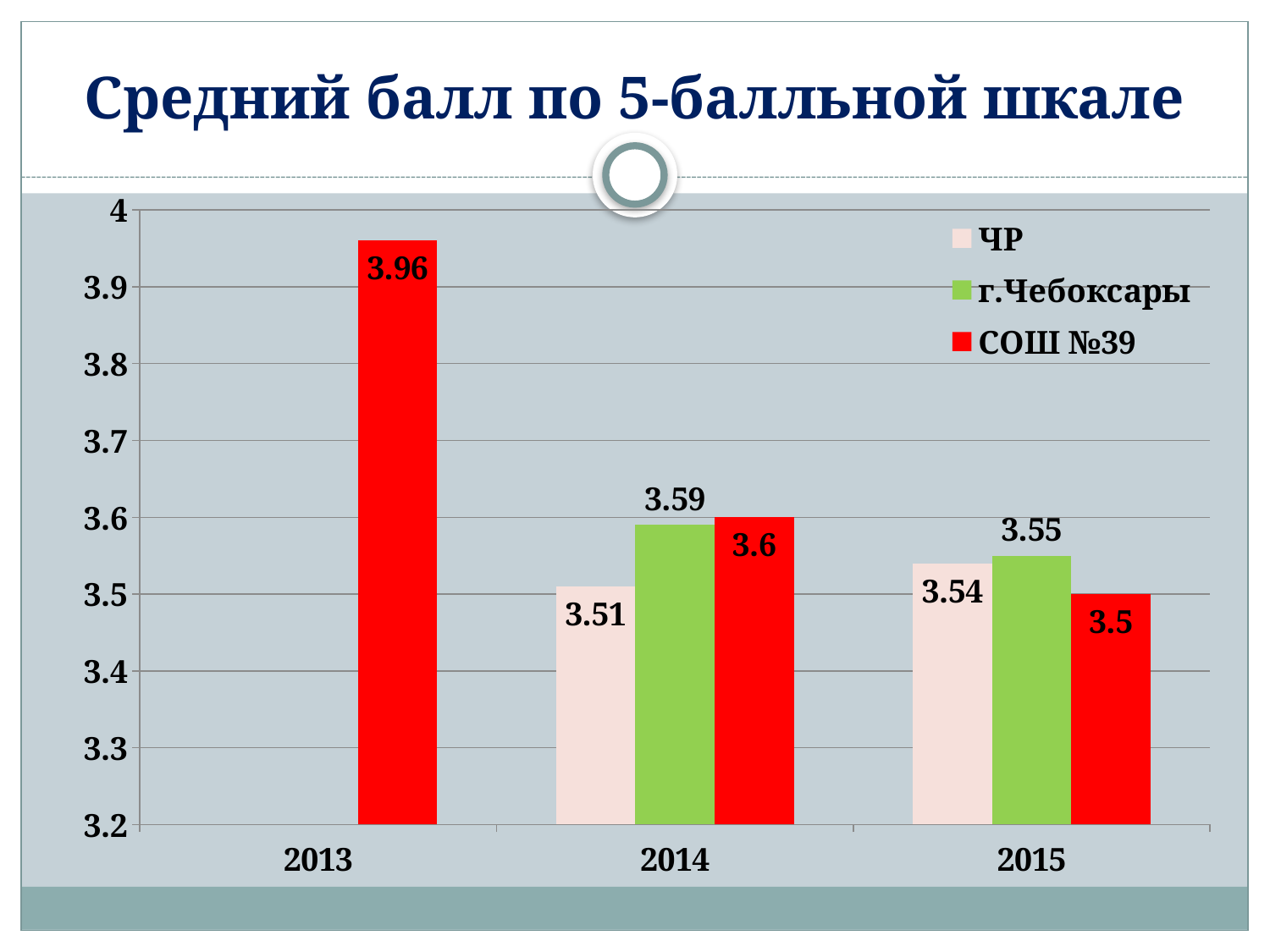
What kind of chart is shown on the slide? bar chart Does the value for СОШ №39 rise or fall from 2013 to 2015? fall What is the value for г.Чебоксары in 2015? 3.55 How many series does the legend list? 3 What is the value for ЧР in 2014? 3.51 Is the value for СОШ №39 in 2013 greater or less than 3.9? greater Which is larger in 2015: the value for ЧР or the value for СОШ №39? ЧР In which year is the value for СОШ №39 the highest? 2013 In which year is the value for СОШ №39 the lowest? 2015 What is the difference between the СОШ №39 values for 2013 and 2014? 0.36 What is the value for СОШ №39 in 2015? 3.5 What is the value for СОШ №39 in 2013? 3.96